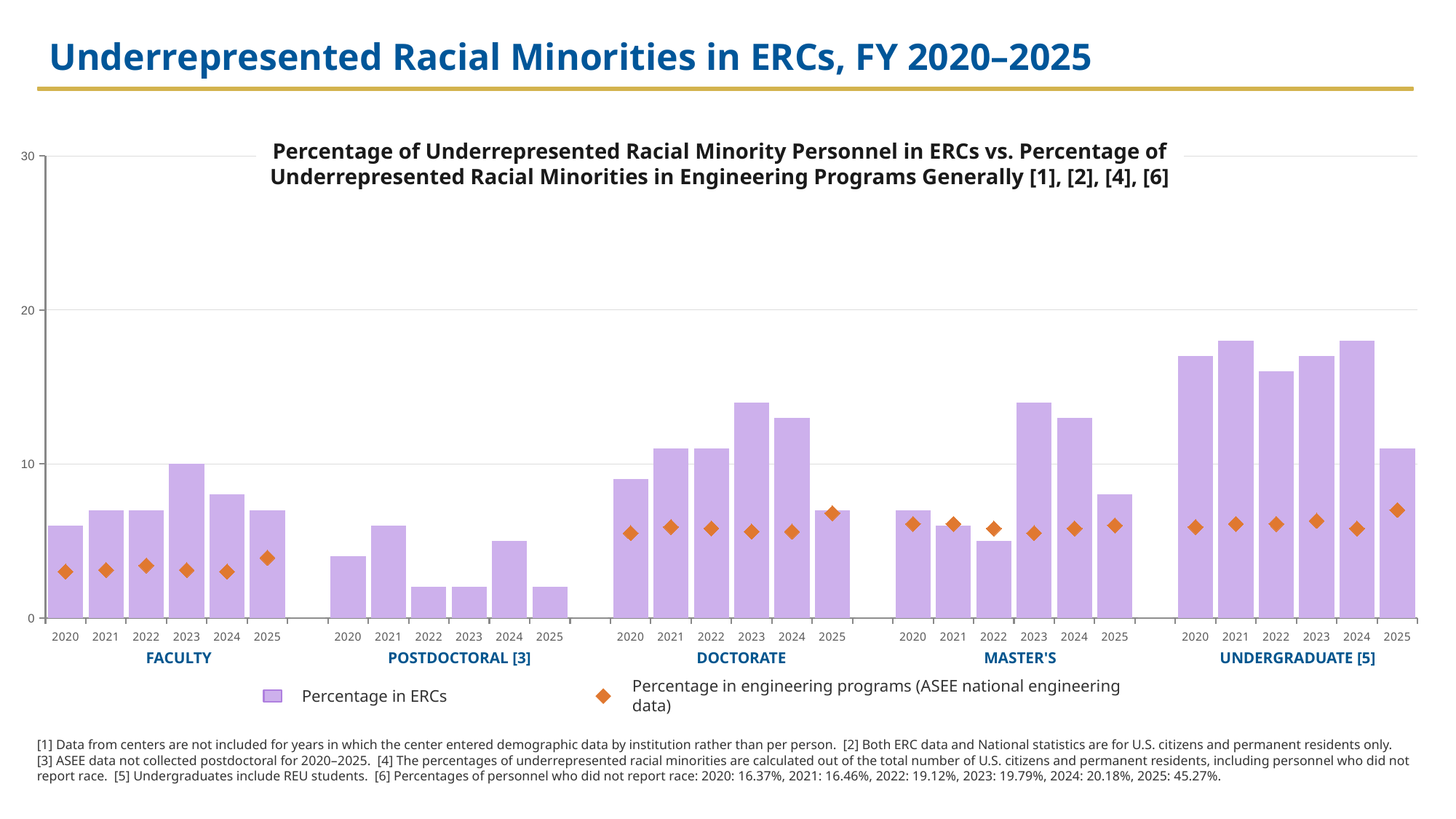
Is the Percentage in ERCs bar for Undergraduate 2021 greater or less than 10? greater How many series does the legend list? 2 Does the Percentage in ERCs for Doctorate rise or fall from 2020 to 2023? rise How many years are plotted for each personnel group? 6 How many personnel groups (categories) are shown along the x axis? 5 Which is larger, the Percentage in ERCs for Undergraduate 2020 or for Faculty 2020? Undergraduate 2020 Is the Percentage in ERCs bar for Doctorate 2023 greater or less than 10? greater Is the Percentage in ERCs bar for Postdoctoral 2022 greater or less than 10? less Within the Master's group, which year has the lowest Percentage in ERCs? 2022 What kind of chart is shown on the slide? bar chart Within the Doctorate group, which year has the highest Percentage in ERCs? 2023 What does the orange diamond marker represent according to the legend? Percentage in engineering programs (ASEE national engineering data)